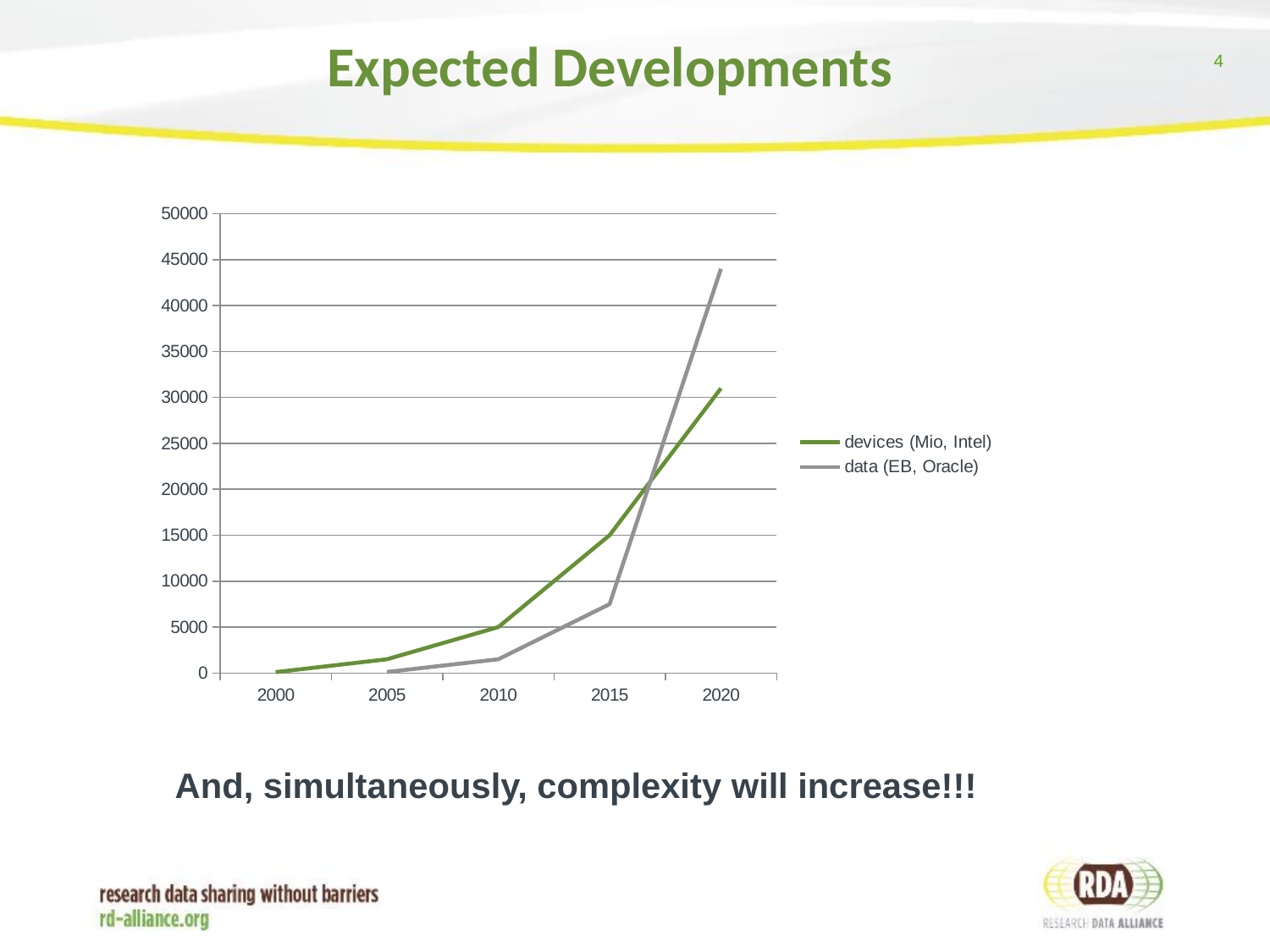
What kind of chart is shown on the slide? line chart Which series has the higher value in 2020, devices (Mio, Intel) or data (EB, Oracle)? data (EB, Oracle) Is the value for devices (Mio, Intel) in 2020 greater or less than 25000? greater Do the values for data (EB, Oracle) rise or fall from 2005 to 2020? rise Which series has the higher value in 2015, devices (Mio, Intel) or data (EB, Oracle)? devices (Mio, Intel) How many years are marked on the x axis? 5 Is the value for data (EB, Oracle) in 2015 greater or less than 10000? less What colour is the line for devices (Mio, Intel)? green Is the value for devices (Mio, Intel) in 2005 greater or less than 5000? less What are the two legend entries of the chart? devices (Mio, Intel) and data (EB, Oracle) How many series does the legend list? 2